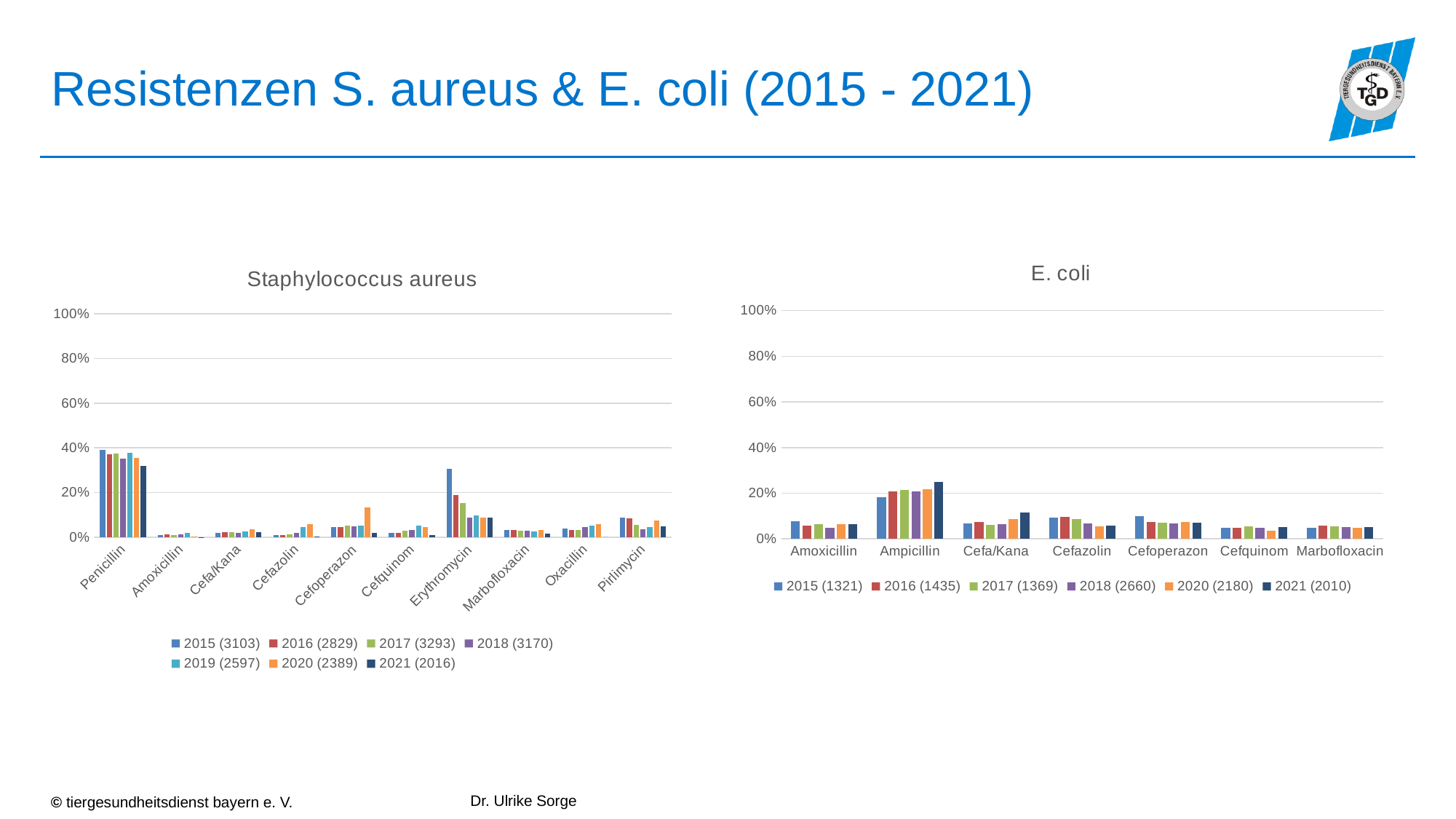
How many series does the legend of the Staphylococcus aureus chart list? 7 In the E. coli chart, what is the legend entry for the 2015 series? 2015 (1321) In the Staphylococcus aureus chart, which antibiotic has the highest resistance values? Penicillin How many antibiotic categories are shown on the x axis of the Staphylococcus aureus chart? 10 In the Staphylococcus aureus chart, is the value for Erythromycin in 2015 greater or less than 20%? greater In the Staphylococcus aureus chart, which is larger in 2015: Penicillin or Erythromycin? Penicillin How many antibiotic categories are shown on the x axis of the E. coli chart? 7 What type of chart is the Staphylococcus aureus chart? bar chart In the Staphylococcus aureus chart, do the values for Erythromycin rise or fall from 2015 to 2021? fall In the E. coli chart, is the value for Amoxicillin in 2015 greater or less than 20%? less How many series does the legend of the E. coli chart list? 6 In the E. coli chart, which antibiotic has the highest resistance values? Ampicillin